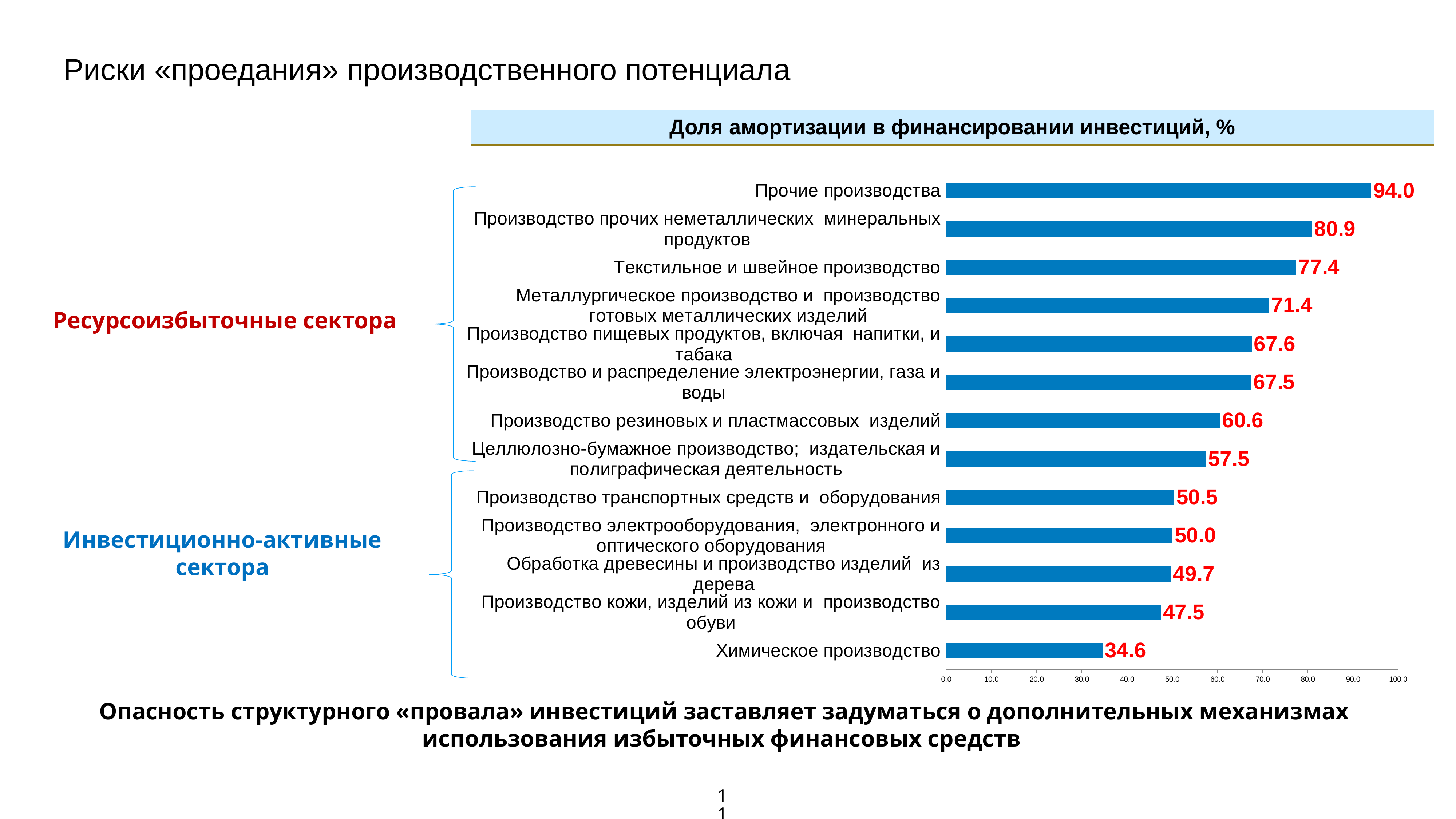
What is the value for Производство транспортных средств и оборудования? 50.5 What is the value for Производство резиновых и пластмассовых изделий? 60.6 Which category has the highest value? Прочие производства Is the value for Производство прочих неметаллических минеральных продуктов greater or less than 80.0? greater What kind of chart is shown on the slide? bar chart What is the difference between the values for Прочие производства and Химическое производство? 59.4 How many categories are shown in the chart? 13 What is the value for Химическое производство? 34.6 What is the title of the chart? Доля амортизации в финансировании инвестиций, % Which category has the lowest value? Химическое производство What is the value for Текстильное и швейное производство? 77.4 Which is larger: the value for Металлургическое производство и производство готовых металлических изделий or the value for Производство кожи, изделий из кожи и производство обуви? Металлургическое производство и производство готовых металлических изделий